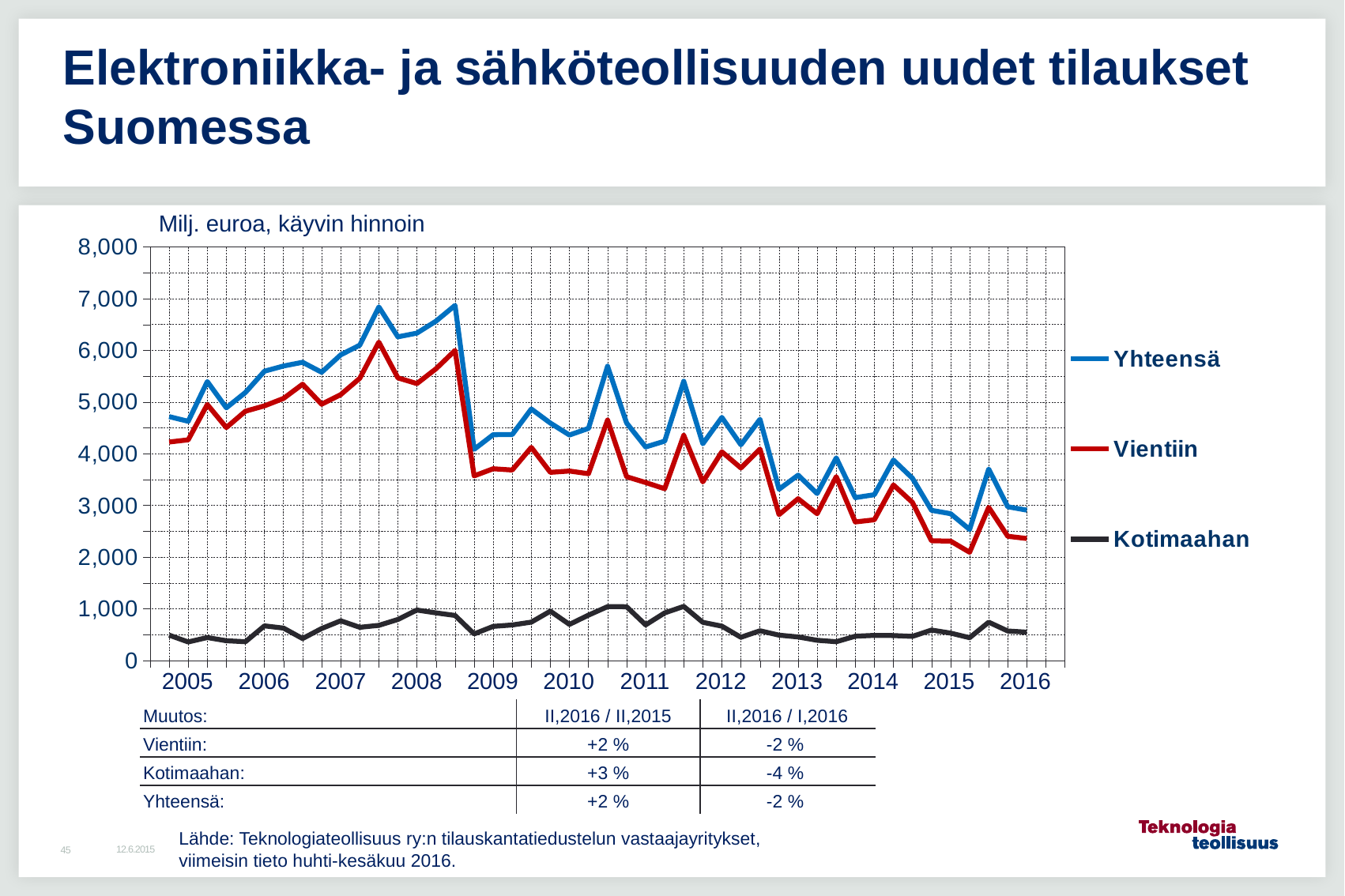
Which series has the lowest values throughout the chart? Kotimaahan What unit is given above the chart's y axis? Milj. euroa, käyvin hinnoin Is the value of the Kotimaahan series ever greater or less than 2,000 across the whole chart? less Is the peak value of the Yhteensä series around 2008 greater or less than 6,000? greater Is the value of the Yhteensä series at the start of 2005 greater or less than 4,000? greater Which series has the highest values throughout the chart? Yhteensä How many series does the chart legend list? 3 What kind of chart is shown on the slide? line chart Does the Yhteensä series overall rise or fall from 2005 to 2016? fall What are the three series named in the chart legend? Yhteensä, Vientiin, Kotimaahan Which series is larger in 2012, Vientiin or Kotimaahan? Vientiin